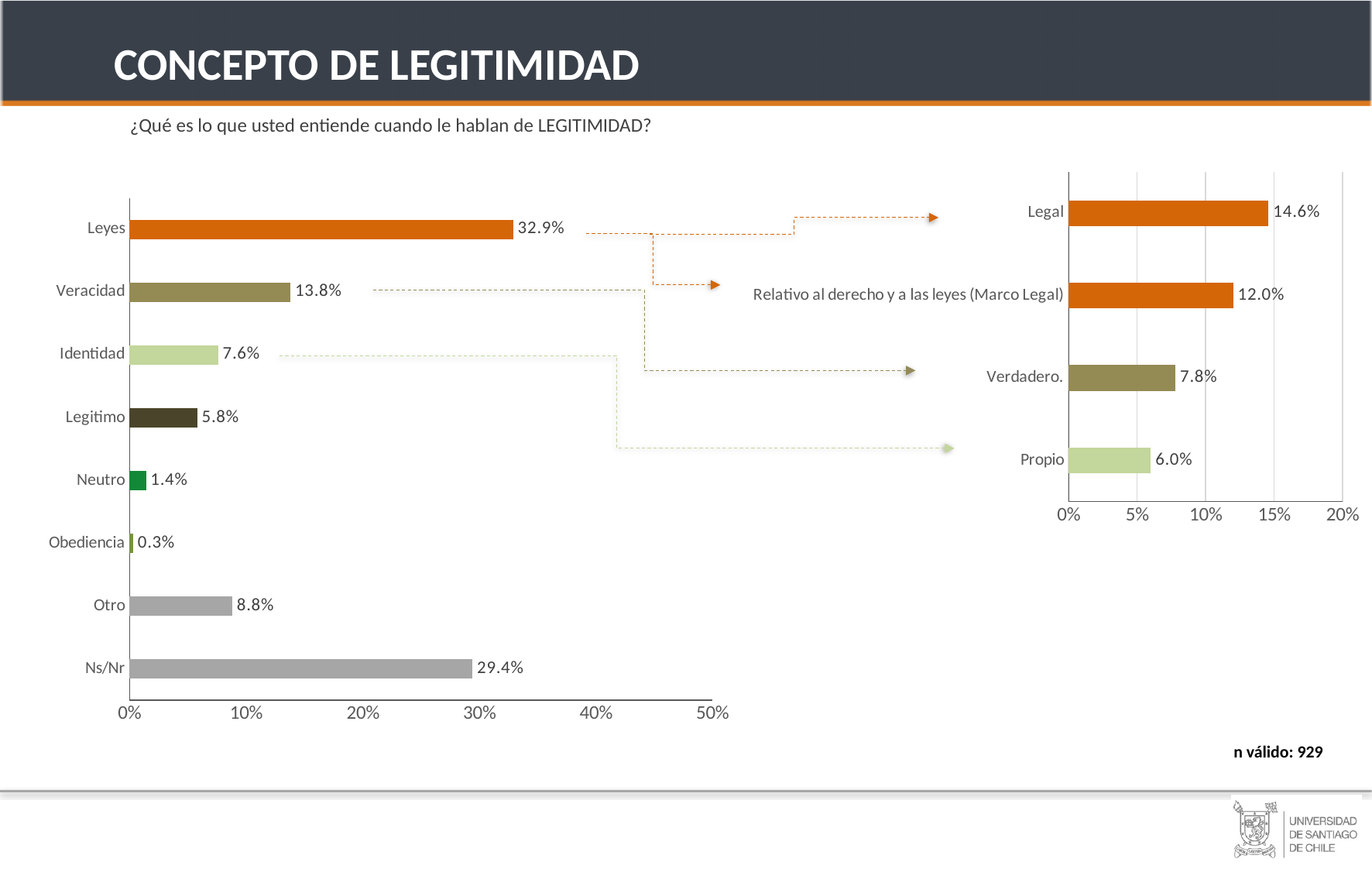
In the left chart, which is larger, Otro or Identidad? Otro In the left chart, what is the value for Ns/Nr? 29.4% In the left chart, what is the value for Leyes? 32.9% How many categories does the left chart show? 8 In the left chart, which category has the highest value? Leyes In the left chart, what is the difference between Leyes and Veracidad? 19.1% In the right chart, which category has the lowest value? Propio In the right chart, what is the value for Verdadero.? 7.8% What kind of chart is the left chart? Bar chart In the left chart, which category has the lowest value? Obediencia In the right chart, what is the difference between Legal and Relativo al derecho y a las leyes (Marco Legal)? 2.6% In the right chart, what is the value for Legal? 14.6%